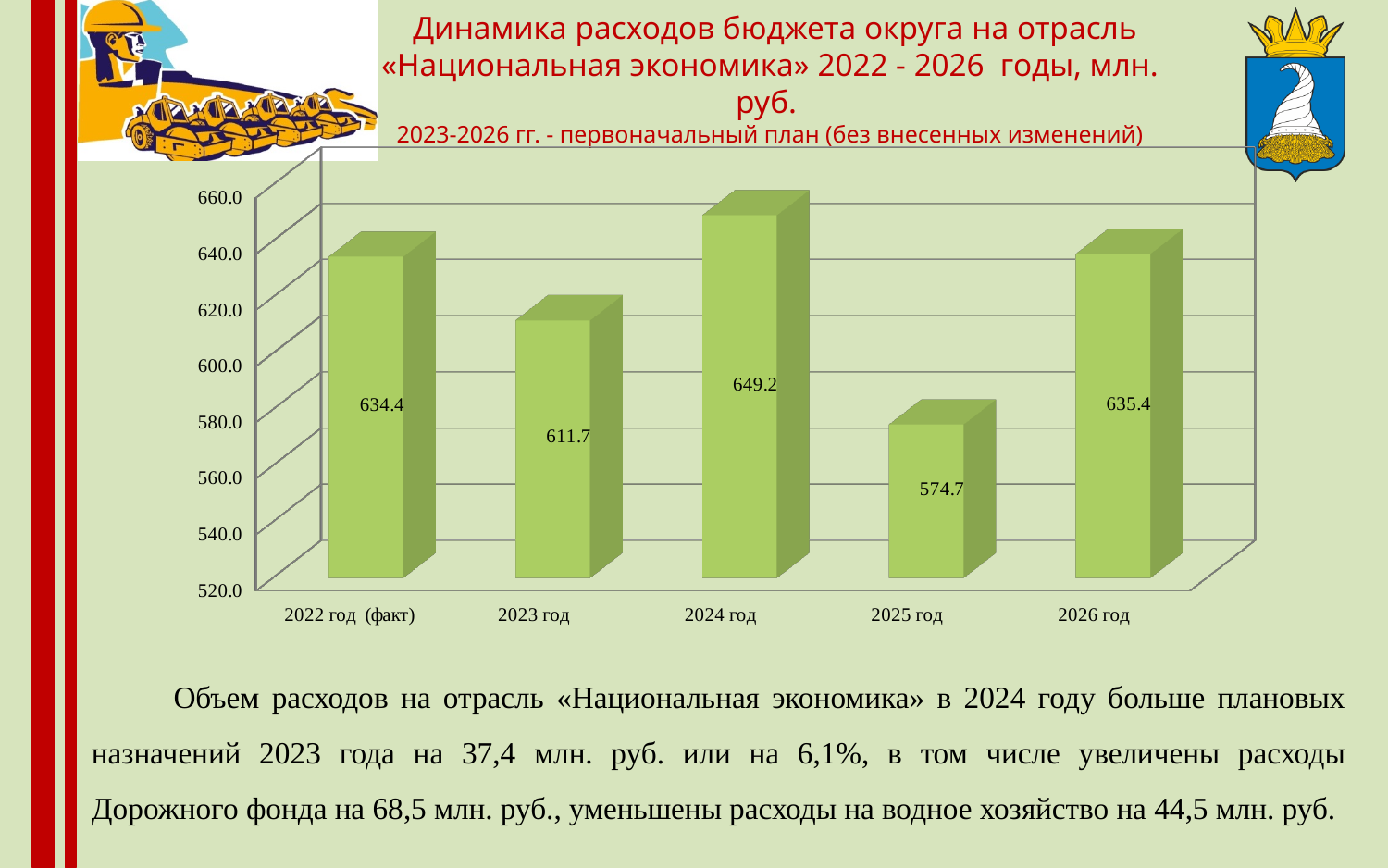
Which year has the highest value? 2024 год What is the difference between the values for 2024 год and 2025 год? 74.5 What kind of chart is shown on the slide? bar chart What is the difference between the values for 2026 год and 2023 год? 23.7 Which year has the lowest value? 2025 год What is the value for 2025 год? 574.7 What is the value for 2022 год (факт)? 634.4 Which is larger, the value for 2023 год or the value for 2025 год? 2023 год What is the value for 2024 год? 649.2 Is the value for 2025 год greater or less than 600.0? less Does the value rise or fall from 2024 год to 2025 год? fall How many years are shown on the chart? 5